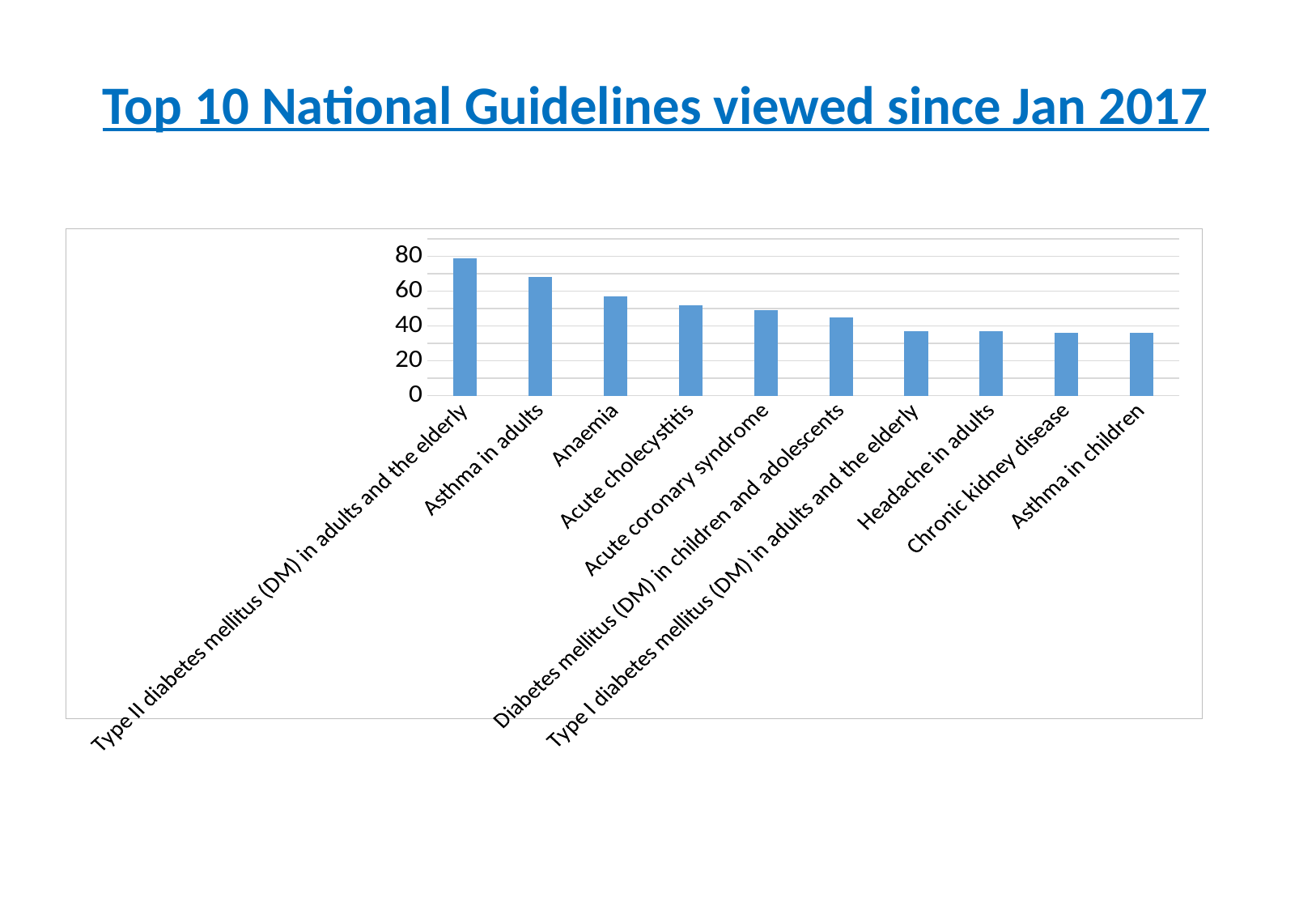
Which has more views, Anaemia or Chronic kidney disease? Anaemia Is the value for Anaemia greater or less than 60? less Which has more views, Asthma in adults or Asthma in children? Asthma in adults Is the value for Type II diabetes mellitus (DM) in adults and the elderly greater or less than 60? greater Which guideline has the highest number of views? Type II diabetes mellitus (DM) in adults and the elderly Do the values rise or fall moving from left to right along the x axis? fall Is the value for Diabetes mellitus (DM) in children and adolescents greater or less than 40? greater What is the title of the slide? Top 10 National Guidelines viewed since Jan 2017 How many categories (guidelines) are plotted on the chart? 10 What kind of chart is shown on the slide? bar chart